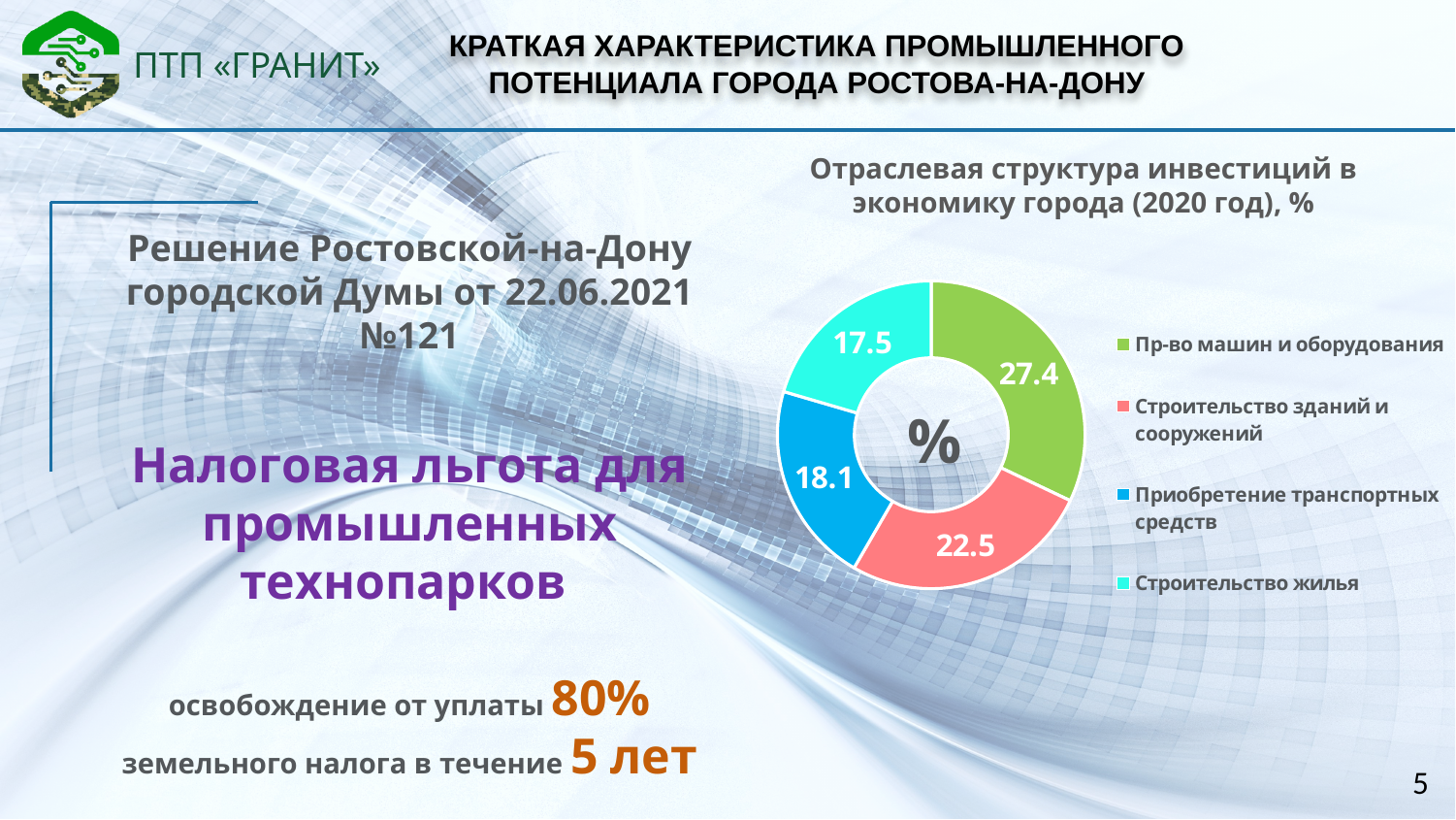
What is the difference between the values for «Пр-во машин и оборудования» and «Строительство зданий и сооружений»? 4.9 How many categories does the chart show? 4 Which is larger: the value for «Строительство зданий и сооружений» or the value for «Приобретение транспортных средств»? Строительство зданий и сооружений What is the value for «Приобретение транспортных средств» in the chart? 18.1 What is the difference between the values for «Приобретение транспортных средств» and «Строительство жилья»? 0.6 Which category has the smallest value in the chart? Строительство жилья What is the value for «Строительство жилья» in the chart? 17.5 What kind of chart is shown on the slide? doughnut (pie) chart Which category has the largest value in the chart? Пр-во машин и оборудования What is the value for «Строительство зданий и сооружений» in the chart? 22.5 What is the title of the chart? Отраслевая структура инвестиций в экономику города (2020 год), % What is the value for «Пр-во машин и оборудования» in the chart? 27.4